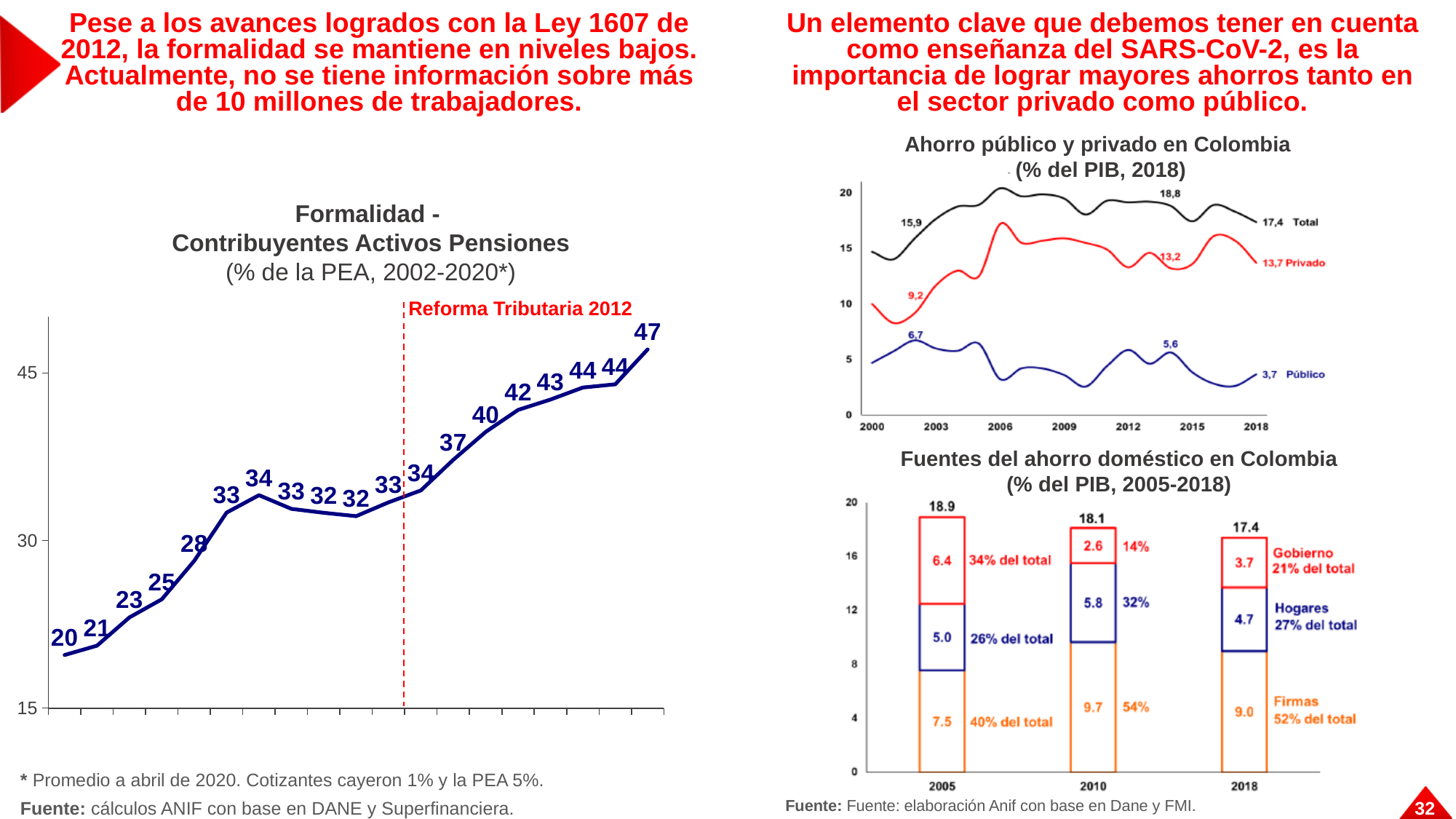
In the chart 'Fuentes del ahorro doméstico en Colombia', what is the total of the stacked bar for 2005? 18.9 In the chart 'Formalidad - Contribuyentes Activos Pensiones', how many data points are plotted on the line? 19 In the chart 'Ahorro público y privado en Colombia', how many series are plotted? 3 In the chart 'Fuentes del ahorro doméstico en Colombia', which is larger in 2018: Hogares or Firmas? Firmas In the chart 'Ahorro público y privado en Colombia', what is the value of Total in 2018? 17,4 In the chart 'Fuentes del ahorro doméstico en Colombia', what is the difference between the Gobierno value in 2005 and in 2018? 2.7 In the chart 'Ahorro público y privado en Colombia', what is the value of Público in 2018? 3,7 In the chart 'Formalidad - Contribuyentes Activos Pensiones', what is the lowest value plotted? 20 In the chart 'Formalidad - Contribuyentes Activos Pensiones', what is the highest value plotted? 47 What kind of chart is 'Formalidad - Contribuyentes Activos Pensiones'? line chart In the chart 'Fuentes del ahorro doméstico en Colombia', what is the value of Firmas in 2010? 9.7 In the chart 'Formalidad - Contribuyentes Activos Pensiones', do the values generally rise or fall from left to right? rise